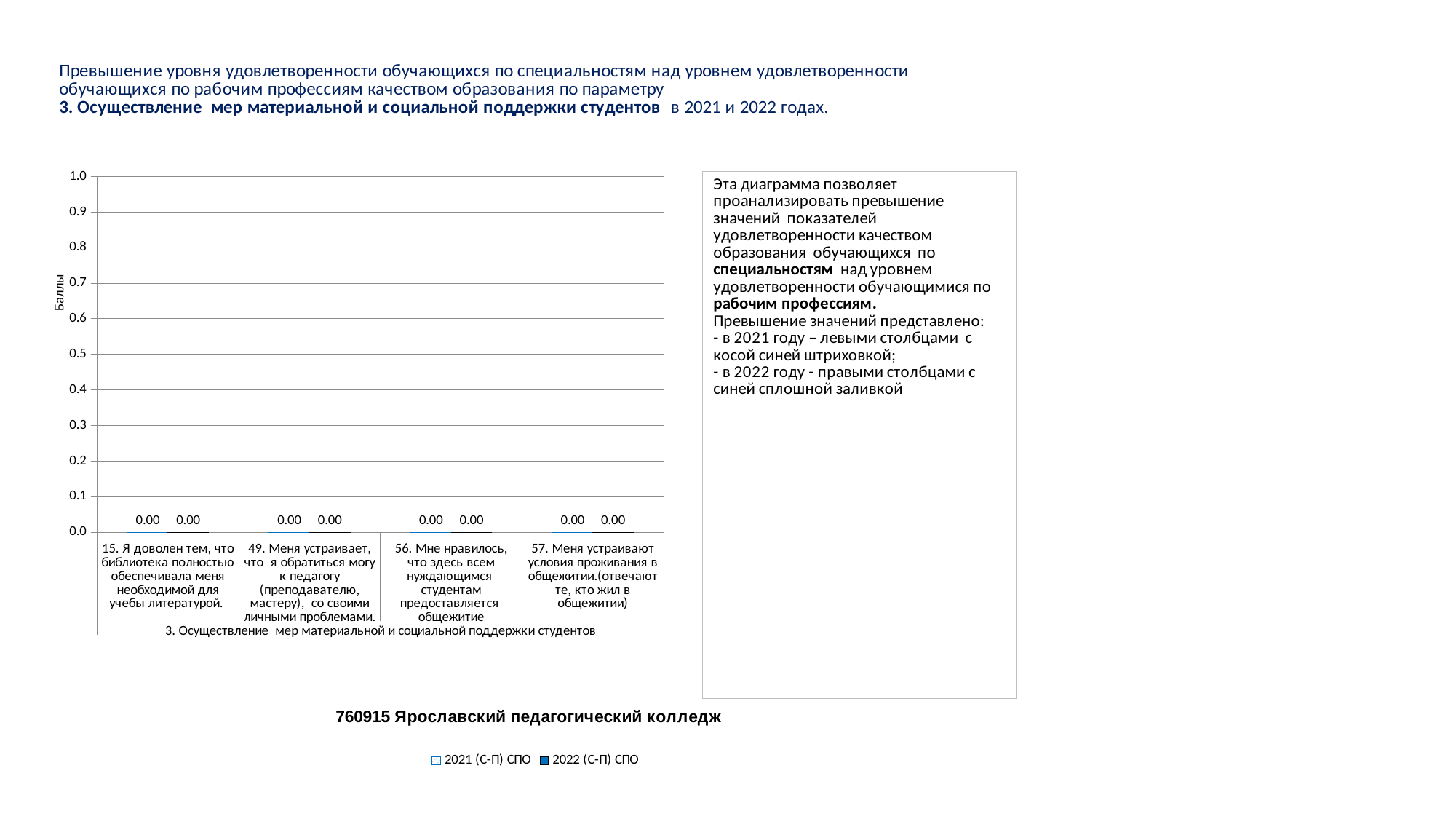
What is the label of the vertical axis? Баллы Is the value for 2022 (С-П) СПО for category 49 greater or less than 0.1? less What is the title of the chart? 760915 Ярославский педагогический колледж What is the value for 2021 (С-П) СПО for category 15 (Я доволен тем, что библиотека полностью обеспечивала меня необходимой для учебы литературой)? 0.00 What is the difference between the 2021 (С-П) СПО and 2022 (С-П) СПО values for category 15? 0.00 How many categories are shown on the x axis of the chart? 4 What is the value for 2022 (С-П) СПО for category 57 (Меня устраивают условия проживания в общежитии)? 0.00 What kind of chart is shown on the slide? bar chart What is the value for 2021 (С-П) СПО for category 56 (Мне нравилось, что здесь всем нуждающимся студентам предоставляется общежитие)? 0.00 What is the value for 2022 (С-П) СПО for category 49 (Меня устраивает, что я обратиться могу к педагогу)? 0.00 How many series does the legend list? 2